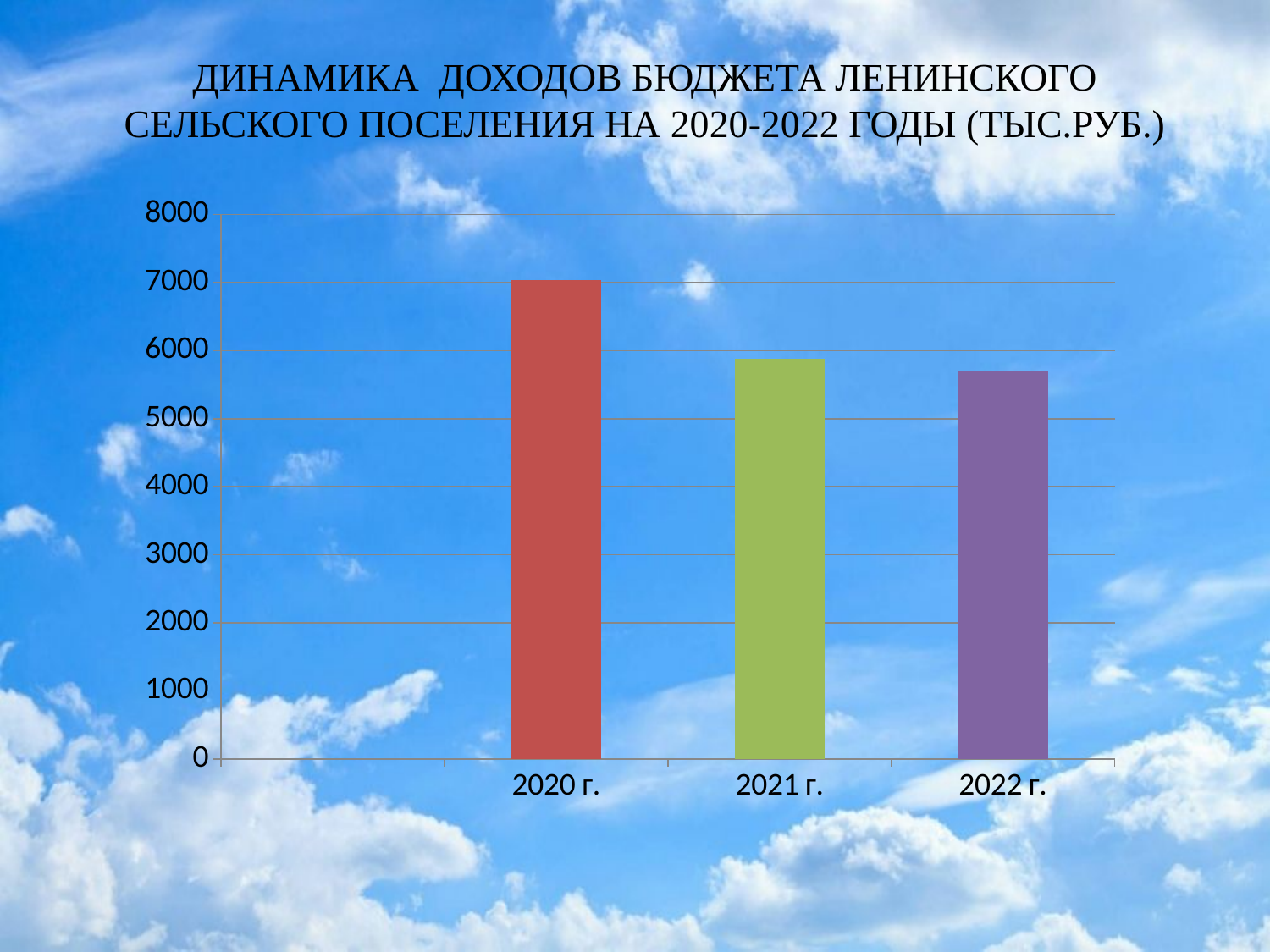
What kind of chart is shown on the slide? bar chart Which year has the lowest budget income in the chart? 2022 г. Which year has the highest budget income in the chart? 2020 г. Is the value for 2022 г. greater or less than 5000? greater What colour is the bar for 2022 г.? purple Do the values rise or fall from 2020 г. to 2022 г.? fall Is the value for 2021 г. greater or less than 6000? less Which is larger, the value for 2020 г. or the value for 2021 г.? 2020 г. Is the value for 2022 г. greater or less than 6000? less How many bars (years) are plotted in the chart? 3 What is the maximum value shown on the vertical axis? 8000